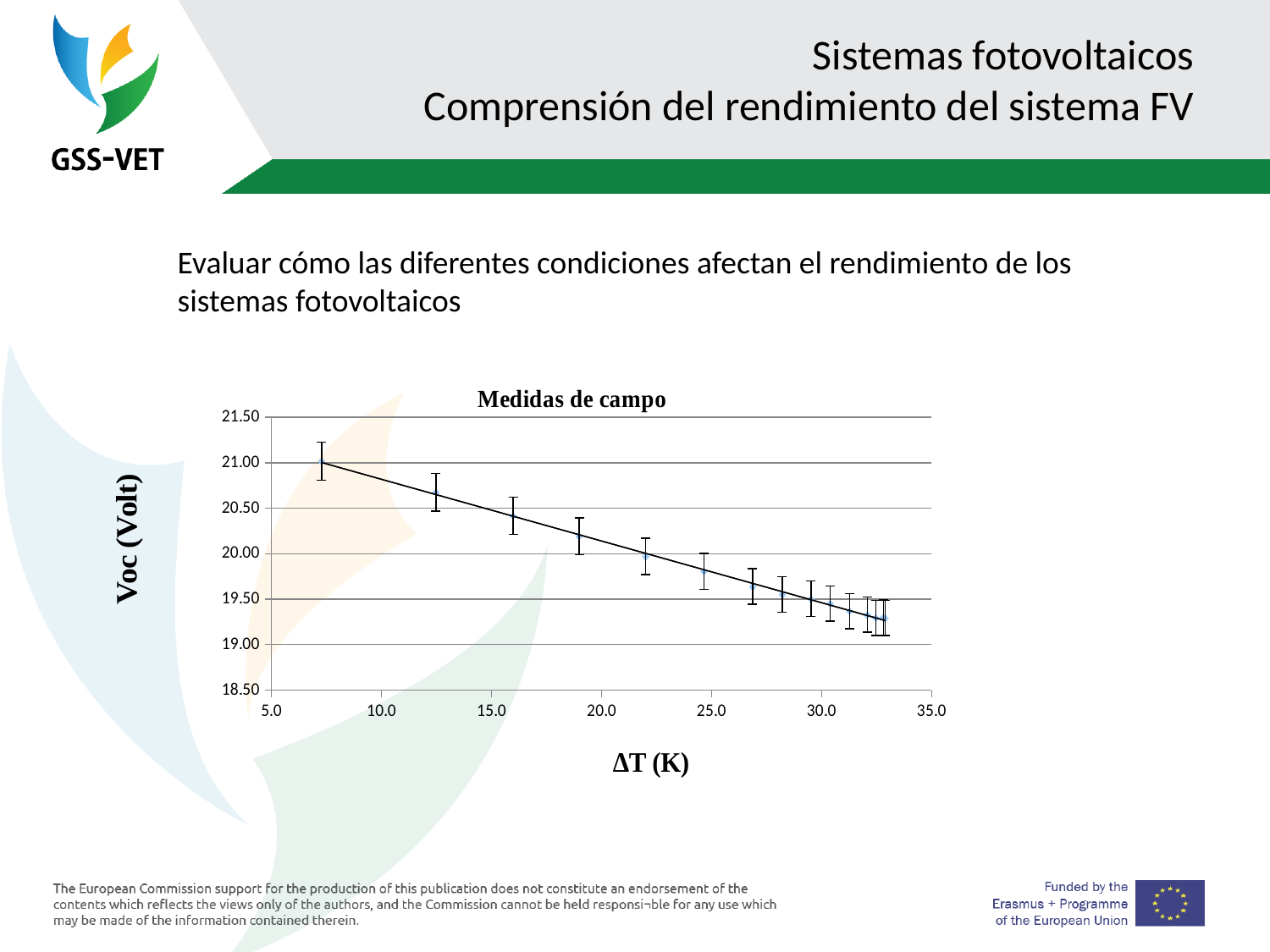
What kind of chart is shown on the slide? scatter chart What is the title of the chart? Medidas de campo What is the label of the x axis of the chart? ΔT (K) Do the Voc values rise or fall as ΔT increases along the x axis? fall Is the Voc value of the rightmost point (highest ΔT) greater or less than 19.50? less Are all the plotted Voc values greater or less than 19.00? greater Is the Voc value of the leftmost point greater or less than 21.50? less Which has the larger Voc value: the point at the lowest ΔT or the point at the highest ΔT? the point at the lowest ΔT